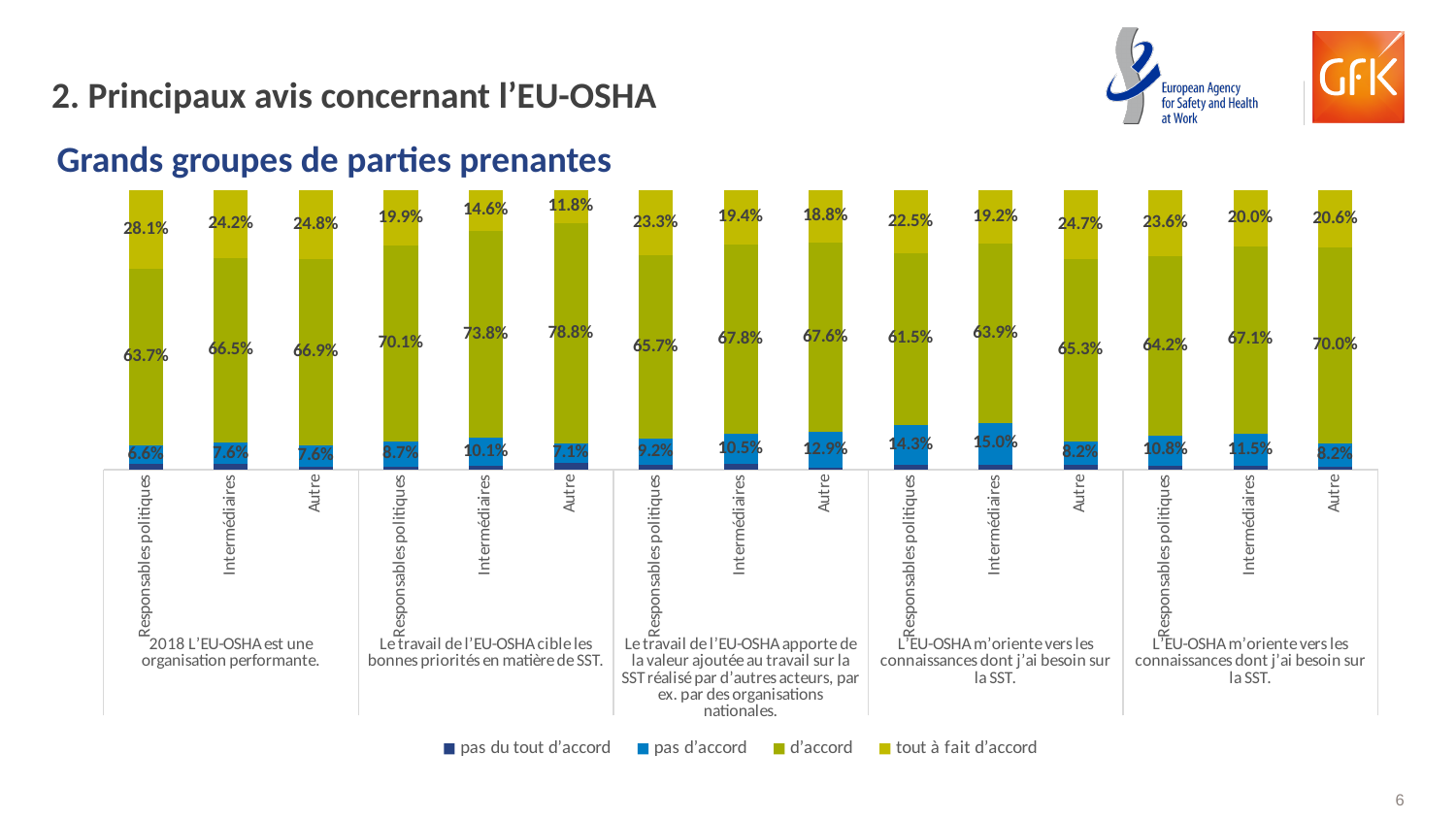
Which bar has the highest 'pas d'accord' value in the chart? Intermédiaires in the fourth group (15.0%) How many series does the legend list? 4 What kind of chart is shown on the slide? Stacked bar chart Which bar has the highest 'd'accord' value in the chart? Autre under 'Le travail de l'EU-OSHA cible les bonnes priorités en matière de SST' (78.8%) What is the 'd'accord' value for Autre under 'Le travail de l'EU-OSHA cible les bonnes priorités en matière de SST'? 78.8% In the fourth group of bars, is the 'tout à fait d'accord' value larger for Autre or for Intermédiaires? Autre Which bar has the lowest 'tout à fait d'accord' value in the chart? Autre under 'Le travail de l'EU-OSHA cible les bonnes priorités en matière de SST' (11.8%) What is the 'pas d'accord' value for Autre under 'Le travail de l'EU-OSHA apporte de la valeur ajoutée au travail sur la SST réalisé par d'autres acteurs'? 12.9% Under 'Le travail de l'EU-OSHA cible les bonnes priorités en matière de SST', what is the difference between the 'd'accord' values for Intermédiaires and Responsables politiques? 3.7 percentage points How many bars are plotted in the chart? 15 What is the 'tout à fait d'accord' value for Responsables politiques under '2018 L'EU-OSHA est une organisation performante'? 28.1% What are the four legend entries of the chart? pas du tout d'accord, pas d'accord, d'accord, tout à fait d'accord